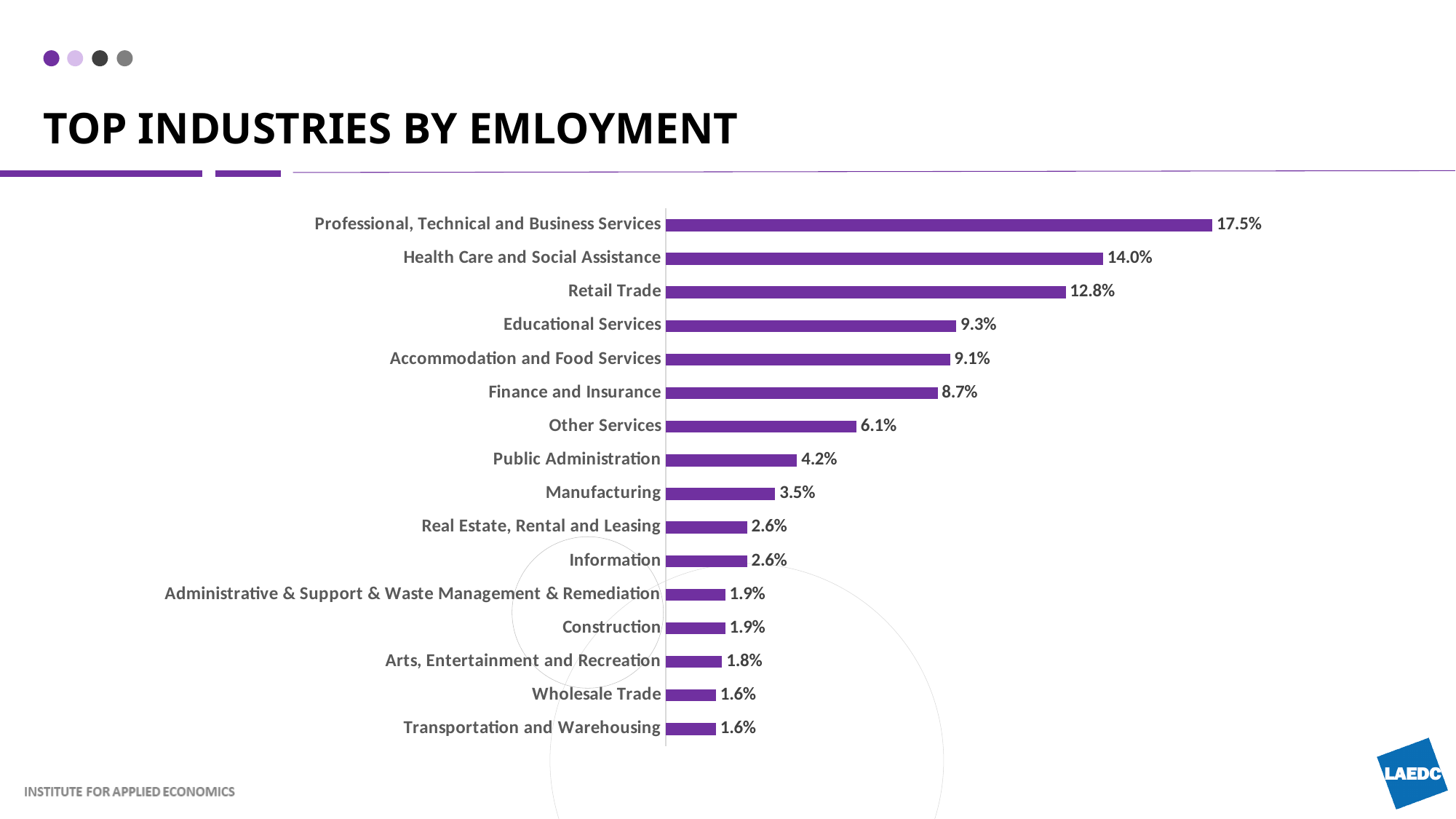
What is the value for Manufacturing? 3.5% What is the difference between Educational Services and Other Services? 3.2% What is the value for Retail Trade? 12.8% Which is larger, Finance and Insurance or Other Services? Finance and Insurance Which industry has the highest employment share? Professional, Technical and Business Services What kind of chart is shown on the slide? Bar chart What is the value for Health Care and Social Assistance? 14.0% Which is larger, Retail Trade or Educational Services? Retail Trade How many industries are shown in the chart? 16 What is the value for Public Administration? 4.2% What is the title of the slide? TOP INDUSTRIES BY EMLOYMENT What is the difference between Professional, Technical and Business Services and Health Care and Social Assistance? 3.5%